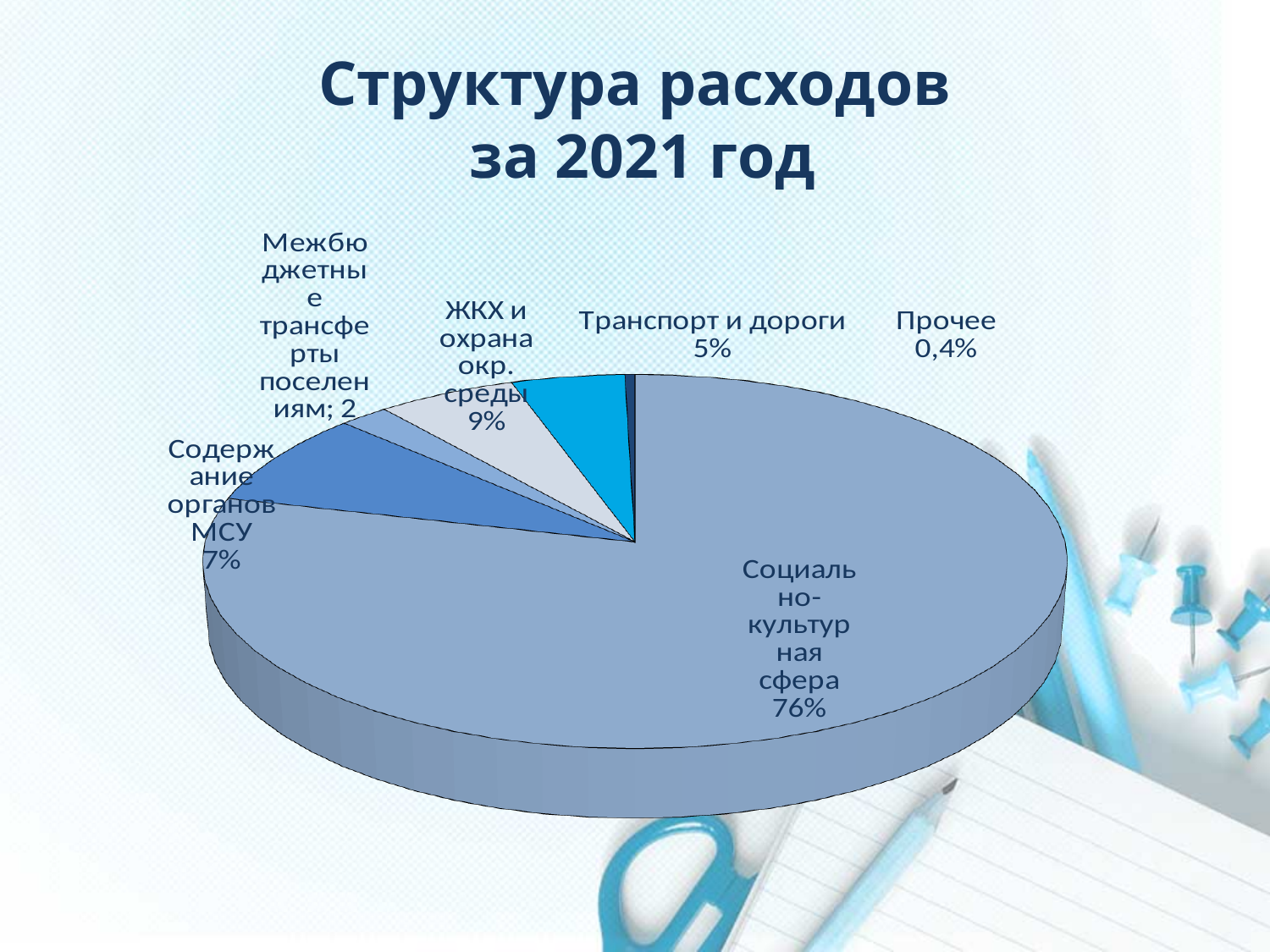
What is the difference in percentage points between Социально-культурная сфера and ЖКХ и охрана окр. среды? 67 What share of expenditures is ЖКХ и охрана окр. среды? 9% Which category has the largest share of expenditures? Социально-культурная сфера What share of expenditures is Транспорт и дороги? 5% What share of expenditures is Социально-культурная сфера? 76% What share of expenditures is Содержание органов МСУ? 7% Which is larger: the share for ЖКХ и охрана окр. среды or for Транспорт и дороги? ЖКХ и охрана окр. среды How many slices does the pie chart have? 6 What share of expenditures is Прочее? 0,4% Which category has the smallest share of expenditures? Прочее What kind of chart is shown on the slide? pie chart What is the title of the chart? Структура расходов за 2021 год